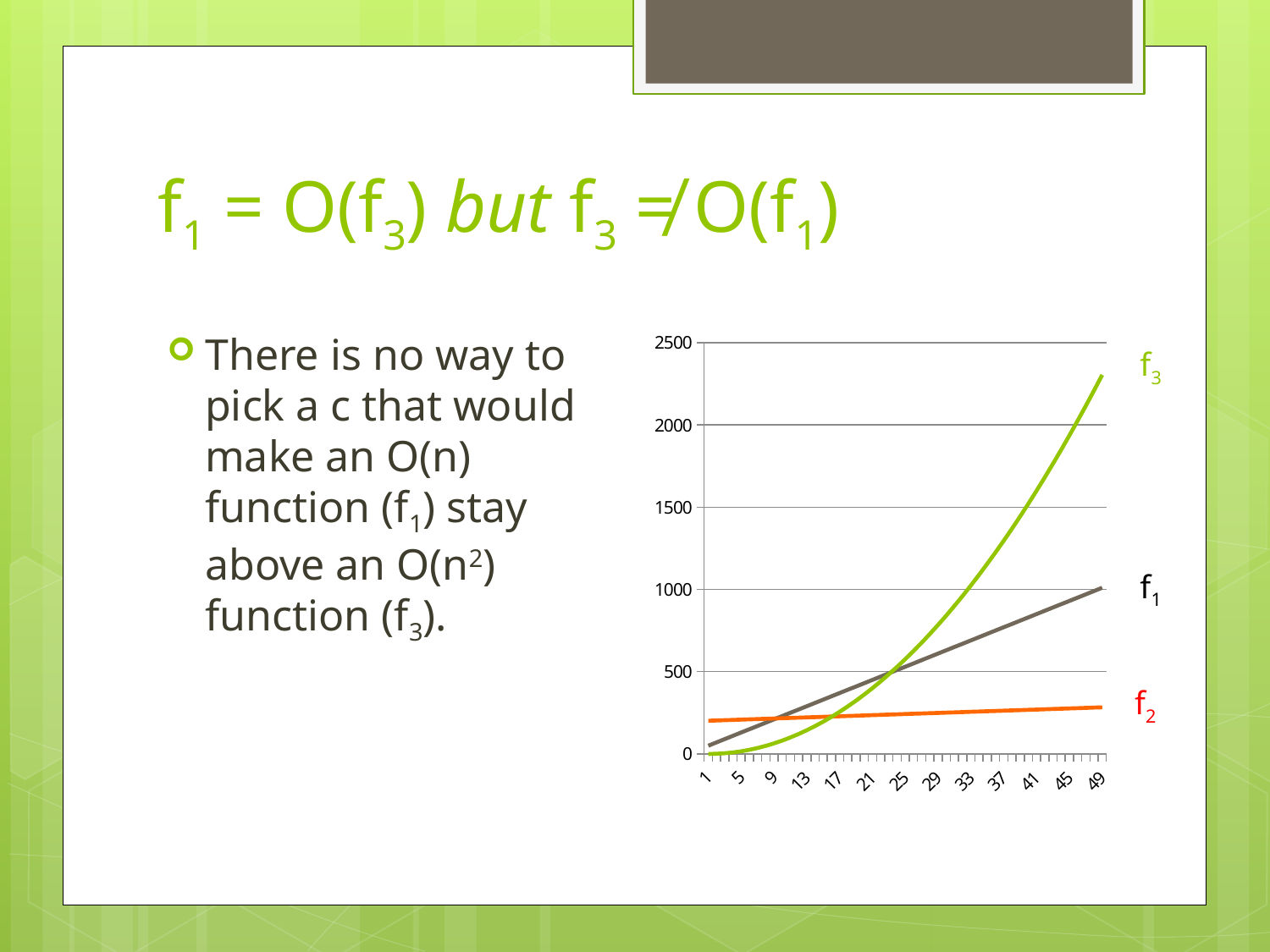
Does f3 rise or fall as x increases along the horizontal axis? rise Which function has the highest value at the right end of the chart (x = 49)? f3 At x = 49, which is larger, f3 or f1? f3 How many functions (series) are plotted on the chart? 3 What colour is the line for f2? orange Is the value of f3 at x = 1 greater or less than 500? less At x = 1, which is larger, f1 or f2? f2 Is the value of f1 at x = 49 greater or less than 500? greater Is the value of f2 at x = 49 greater or less than 500? less Which function has the lowest value at the right end of the chart (x = 49)? f2 What kind of chart is shown on the slide? line chart